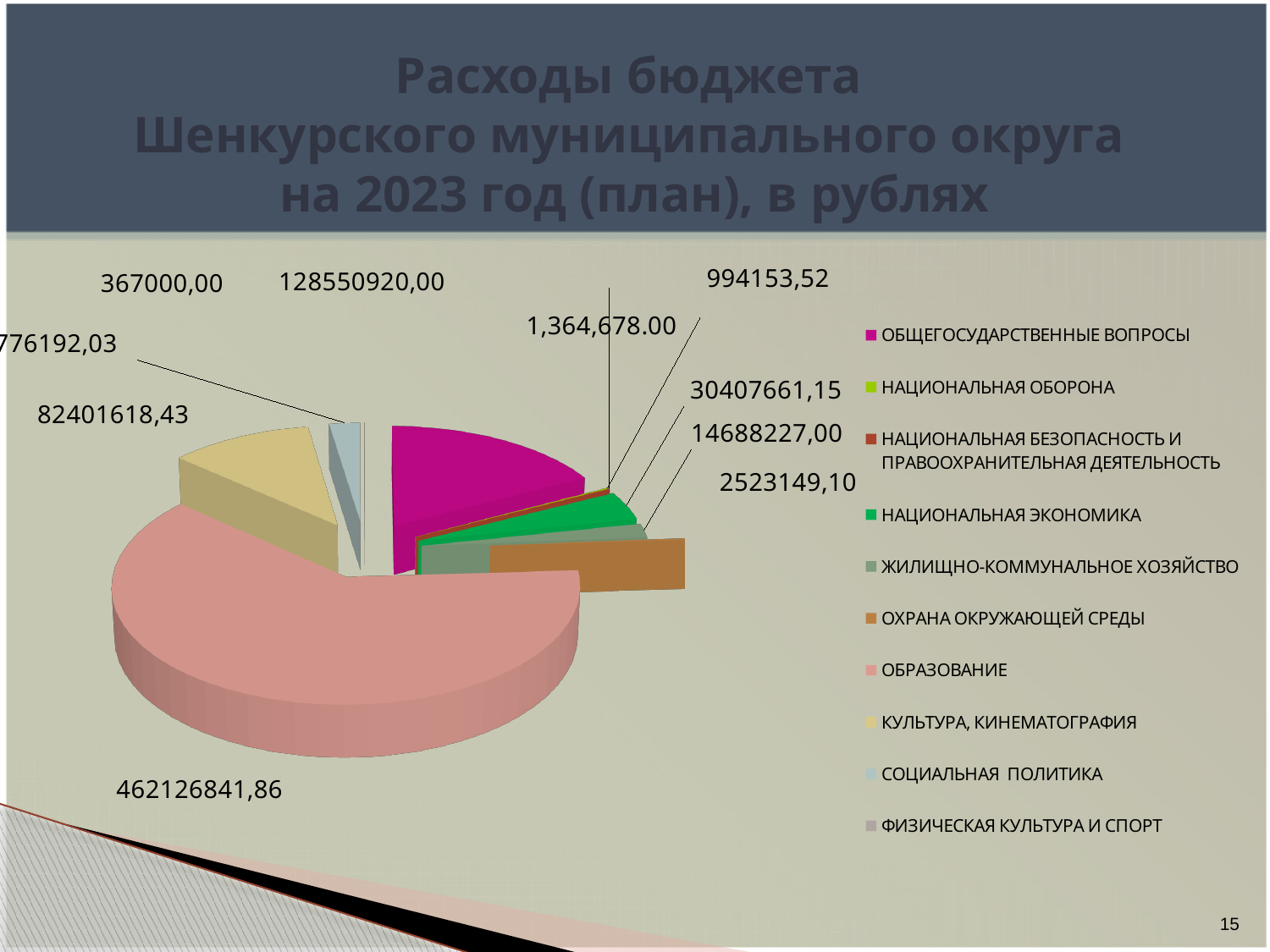
Which is larger, the slice for ОБРАЗОВАНИЕ or the slice for ОБЩЕГОСУДАРСТВЕННЫЕ ВОПРОСЫ? ОБРАЗОВАНИЕ What is the value shown for НАЦИОНАЛЬНАЯ ЭКОНОМИКА? 30407661,15 How many categories does the legend of the pie chart list? 10 What is the value shown for ЖИЛИЩНО-КОММУНАЛЬНОЕ ХОЗЯЙСТВО? 14688227,00 What is the value shown for ОХРАНА ОКРУЖАЮЩЕЙ СРЕДЫ? 2523149,10 What is the value shown for ОБЩЕГОСУДАРСТВЕННЫЕ ВОПРОСЫ? 128550920,00 What is the value shown for КУЛЬТУРА, КИНЕМАТОГРАФИЯ? 82401618,43 What is the value shown for ОБРАЗОВАНИЕ? 462126841,86 What is the title of the chart on the slide? Расходы бюджета Шенкурского муниципального округа на 2023 год (план), в рублях What is the difference between the values for ОБРАЗОВАНИЕ and ОБЩЕГОСУДАРСТВЕННЫЕ ВОПРОСЫ? 333575921,86 Which category has the largest slice in the pie chart? ОБРАЗОВАНИЕ What kind of chart is shown on the slide? pie chart